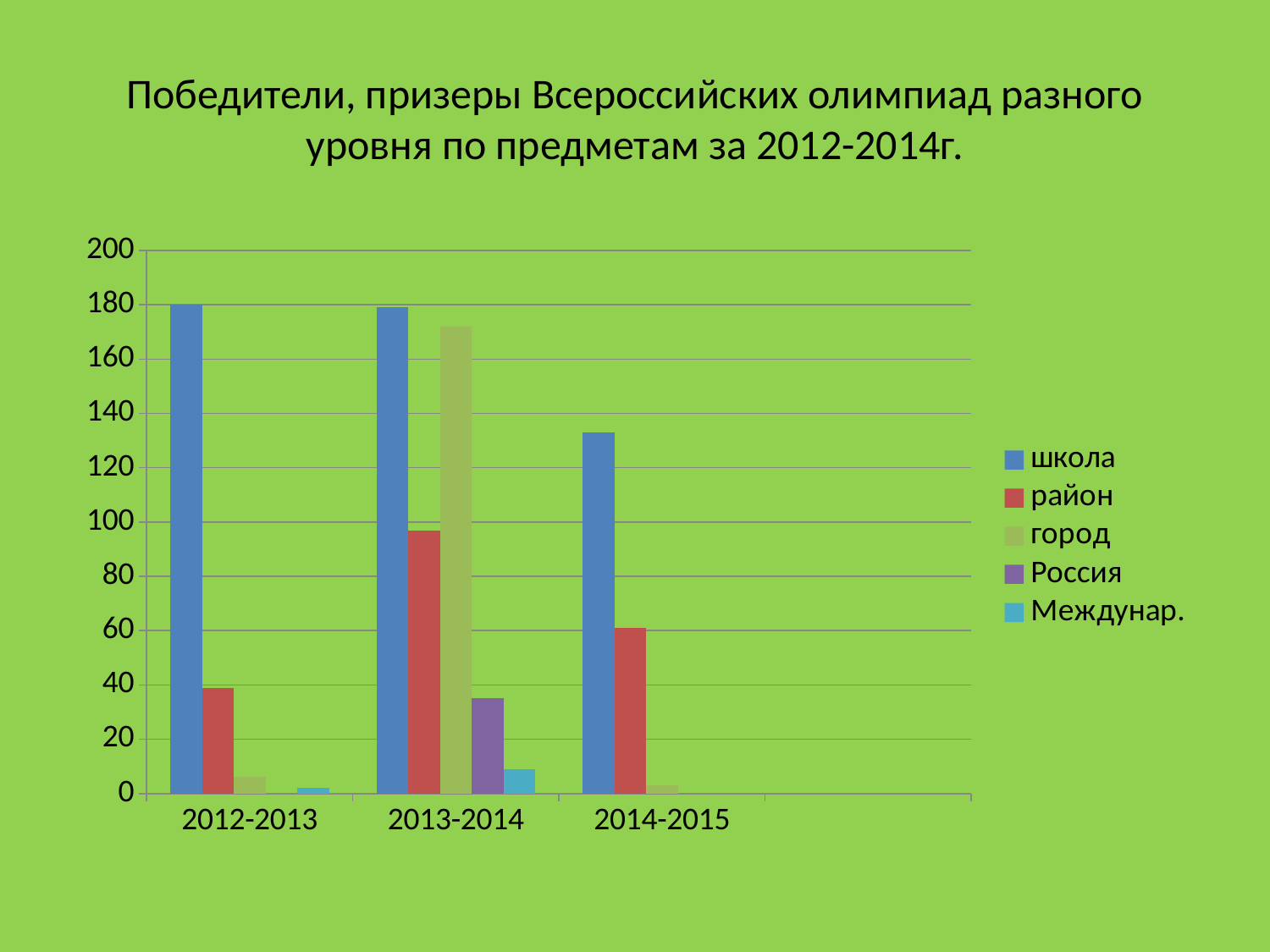
Is the value for школа in 2014-2015 greater or less than 120? greater How many year categories are shown on the x axis? 3 How many series does the legend list? 5 Which series has the highest value in 2014-2015? школа What colour represents the series школа in the legend? blue In which year category is the value for школа the lowest? 2014-2015 Which is larger: the value for район in 2013-2014 or in 2014-2015? 2013-2014 Does the value for район rise or fall from 2013-2014 to 2014-2015? fall Is the value for город in 2013-2014 greater or less than 160? greater Is the value for Россия in 2013-2014 greater or less than 40? less Which series has the lowest value in 2013-2014? Междунар. What kind of chart is shown on the slide? bar chart